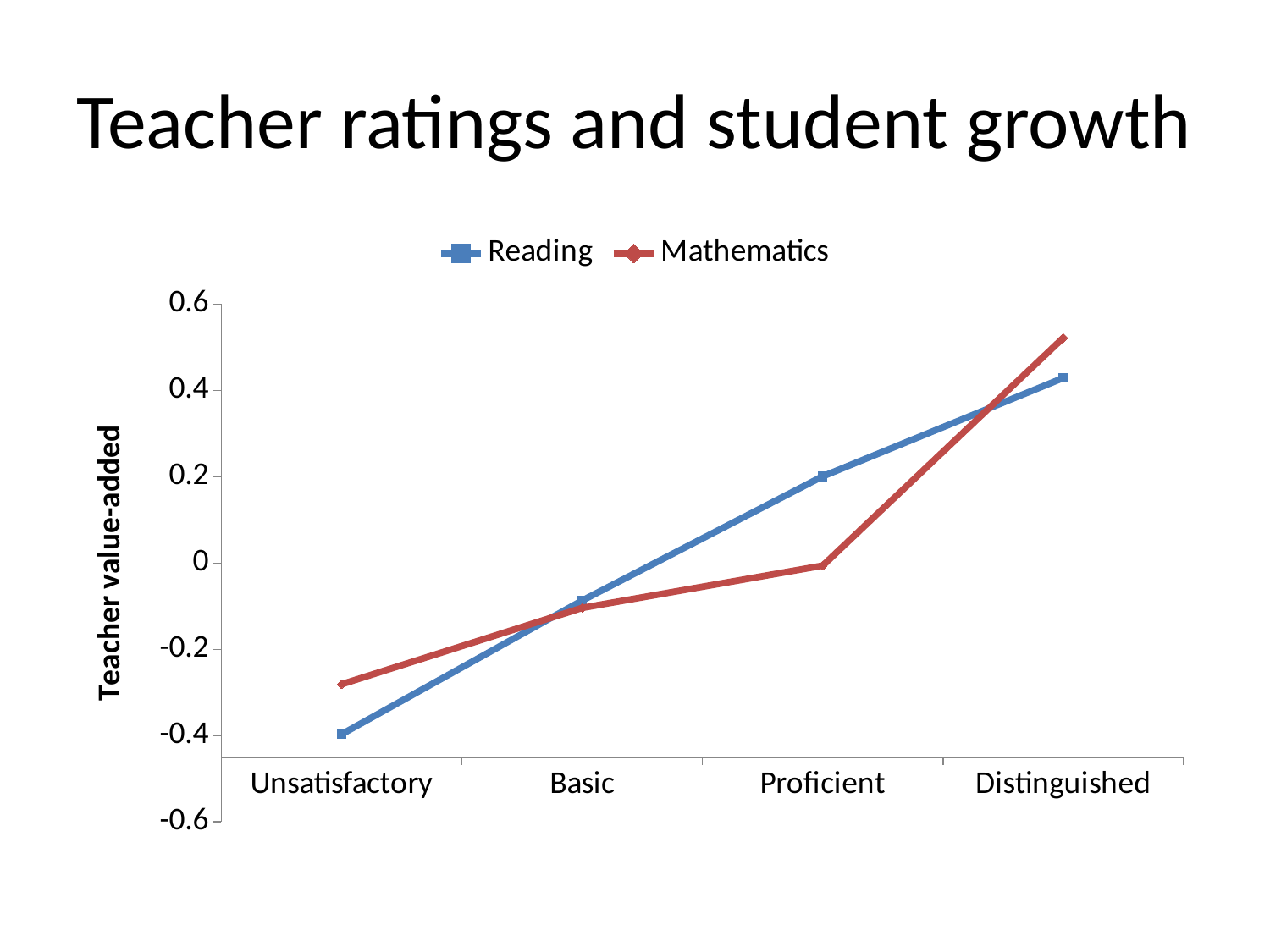
At the Distinguished rating, which series has the higher value, Reading or Mathematics? Mathematics At the Unsatisfactory rating, which series has the higher value, Reading or Mathematics? Mathematics How many series does the legend list? 2 What is the label on the vertical axis? Teacher value-added For which rating category is the Mathematics value highest? Distinguished For which rating category is the Reading value lowest? Unsatisfactory How many teacher rating categories are shown on the x axis? 4 What kind of chart is shown on the slide? line chart Is the Mathematics value for Distinguished greater or less than 0.4? greater Is the Reading value for Unsatisfactory greater or less than -0.2? less Do the Reading values rise or fall from Unsatisfactory to Distinguished? rise Is the Mathematics value for Proficient greater or less than 0.2? less